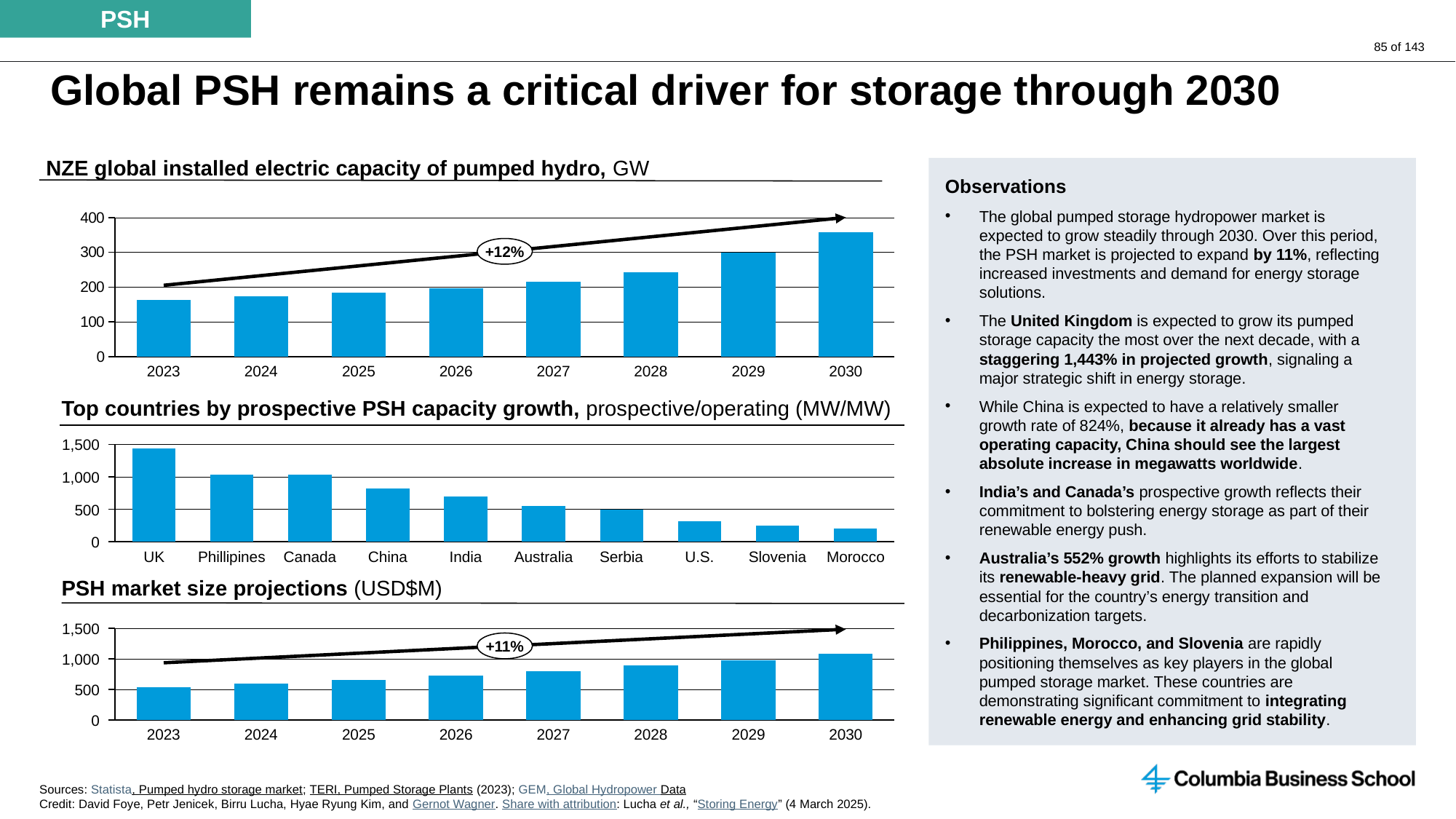
In the chart 'Top countries by prospective PSH capacity growth', is the value for China greater or less than 500? greater In the chart 'Top countries by prospective PSH capacity growth', which country has the lowest value? Morocco In the chart 'Top countries by prospective PSH capacity growth', which is larger, the value for India or the value for U.S.? India In the chart 'NZE global installed electric capacity of pumped hydro, GW', what growth rate is printed on the arrow annotation? +12% In the chart 'Top countries by prospective PSH capacity growth', which country has the highest value? UK In the chart 'PSH market size projections (USD$M)', is the value for 2030 greater or less than 1,000? greater In the chart 'NZE global installed electric capacity of pumped hydro, GW', which year has the highest value? 2030 In the chart 'PSH market size projections (USD$M)', do the values rise or fall from 2023 to 2030? rise In the chart 'NZE global installed electric capacity of pumped hydro, GW', is the value for 2023 greater or less than 200? less In the chart 'Top countries by prospective PSH capacity growth', how many countries are shown? 10 In the chart 'NZE global installed electric capacity of pumped hydro, GW', which year has the lowest value? 2023